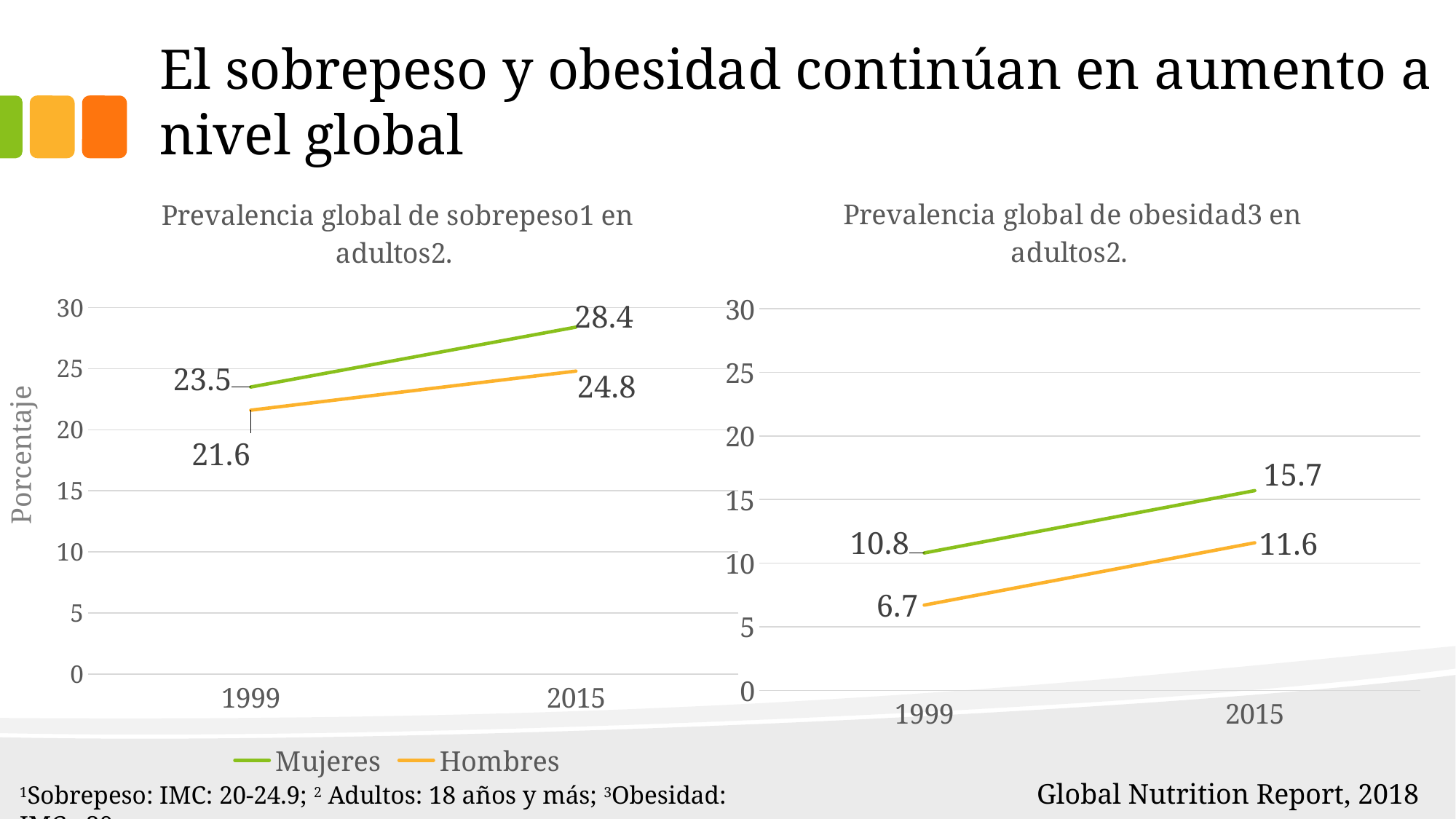
In the right chart (Prevalencia global de obesidad en adultos), which series has the higher value in 1999, Mujeres or Hombres? Mujeres What kind of chart is the left chart (Prevalencia global de sobrepeso en adultos)? line chart How many years are shown on the x axis of the right chart (Prevalencia global de obesidad en adultos)? 2 In the right chart (Prevalencia global de obesidad en adultos), is the value for Hombres in 1999 greater or less than 10? less How many series does the legend list? 2 In the right chart (Prevalencia global de obesidad en adultos), what is the difference between Mujeres and Hombres in 2015? 4.1 In the left chart (Prevalencia global de sobrepeso en adultos), does the Hombres line rise or fall from 1999 to 2015? rise In the right chart (Prevalencia global de obesidad en adultos), what is the value for Hombres in 2015? 11.6 In the left chart (Prevalencia global de sobrepeso en adultos), what is the value for Mujeres in 2015? 28.4 In the left chart (Prevalencia global de sobrepeso en adultos), what is the value for Hombres in 1999? 21.6 In the left chart (Prevalencia global de sobrepeso en adultos), by how much did the Mujeres value increase from 1999 to 2015? 4.9 In the right chart (Prevalencia global de obesidad en adultos), what is the value for Mujeres in 1999? 10.8